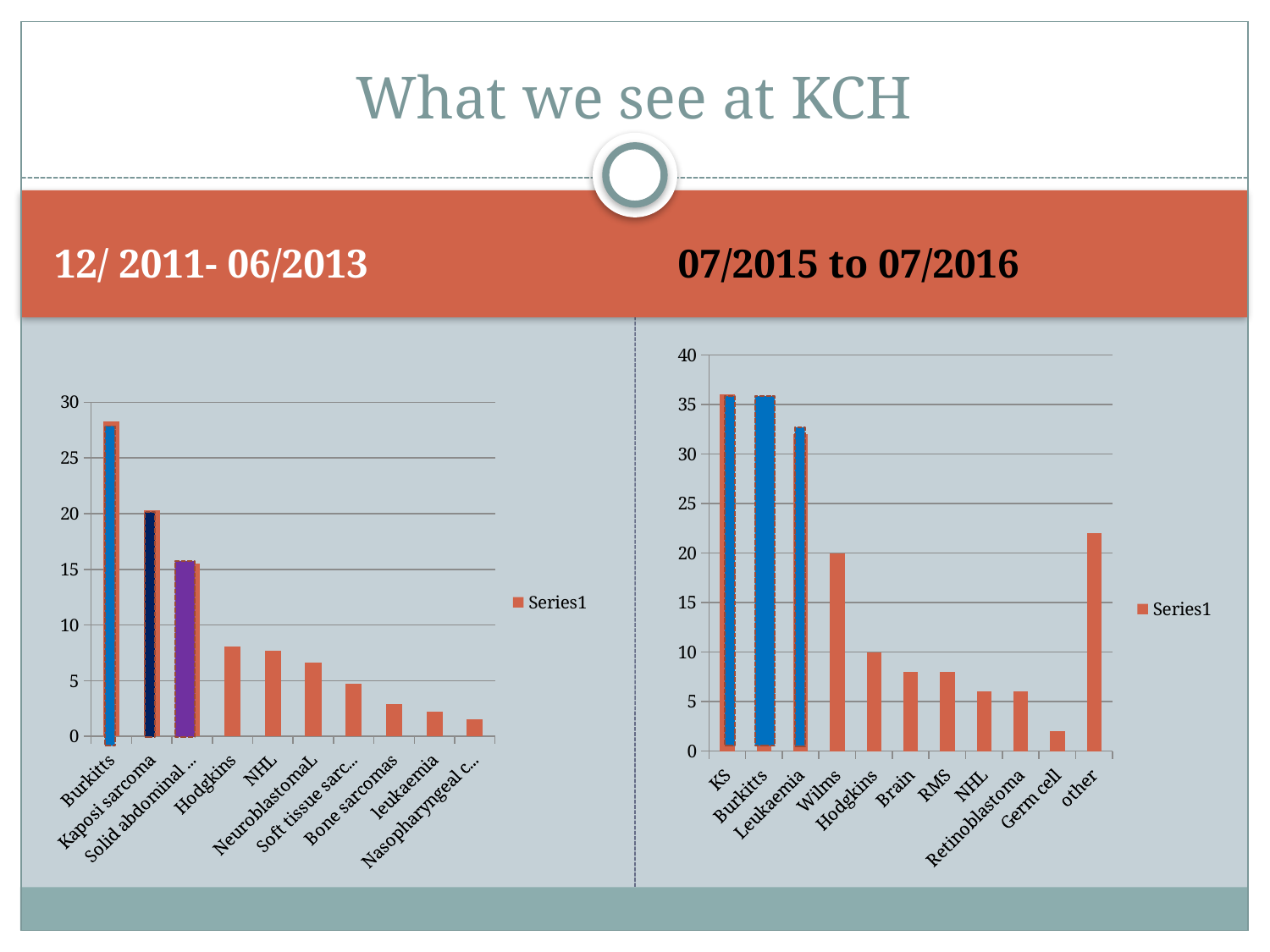
How many categories are shown in the 12/ 2011- 06/2013 chart? 10 In the 07/2015 to 07/2016 chart, is the value for Leukaemia greater or less than 30? greater In the 12/ 2011- 06/2013 chart, is the value for Burkitts greater or less than 25? greater In the 12/ 2011- 06/2013 chart, is the value for Hodgkins greater or less than 10? less In the 07/2015 to 07/2016 chart, which category has the lowest value? Germ cell In the 12/ 2011- 06/2013 chart, which category has the highest value? Burkitts How many categories are shown in the 07/2015 to 07/2016 chart? 11 In the 12/ 2011- 06/2013 chart, which category has the lowest value? Nasopharyngeal c... What type of chart is the 07/2015 to 07/2016 chart? Bar chart In the 07/2015 to 07/2016 chart, what is the value for Wilms? 20 In the 07/2015 to 07/2016 chart, what is the value for Hodgkins? 10 In the 12/ 2011- 06/2013 chart, which is larger, the value for Kaposi sarcoma or the value for NHL? Kaposi sarcoma